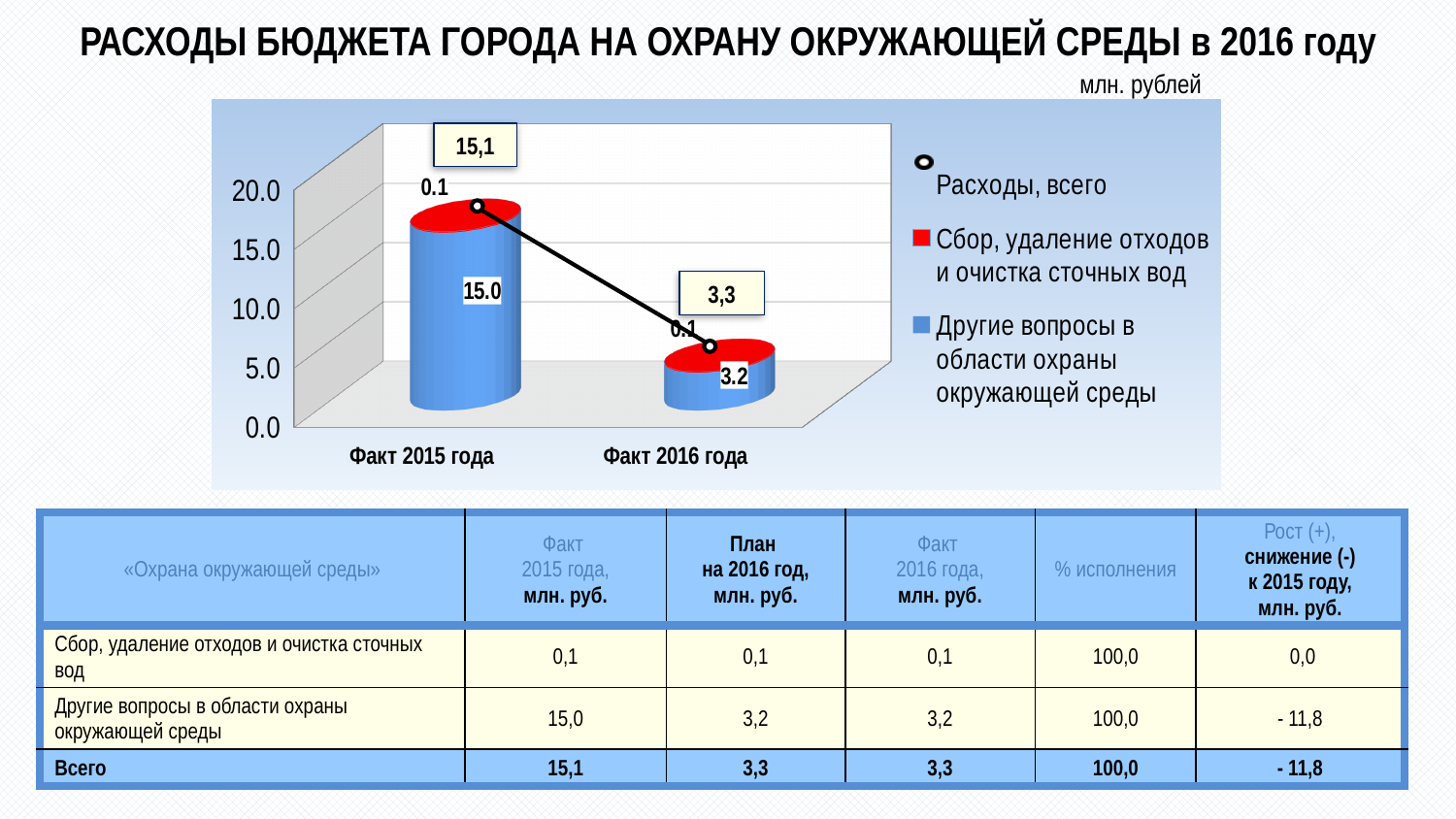
What is the value of the 'Сбор, удаление отходов и очистка сточных вод' series for 'Факт 2015 года'? 0.1 What is the difference between the 'Другие вопросы в области охраны окружающей среды' values for 'Факт 2015 года' and 'Факт 2016 года'? 11.8 Does the total expenditure rise or fall from 'Факт 2015 года' to 'Факт 2016 года'? fall Is the total for 'Факт 2016 года' greater or less than 5.0? less How many categories are shown on the x axis of the chart? 2 How many series does the chart legend list? 3 Which category has the higher total expenditure, 'Факт 2015 года' or 'Факт 2016 года'? Факт 2015 года What total is labelled for 'Факт 2016 года' on the chart? 3,3 What is the value of the 'Другие вопросы в области охраны окружающей среды' series for 'Факт 2016 года'? 3.2 What total is labelled for 'Факт 2015 года' on the chart? 15,1 What is the value of the 'Другие вопросы в области охраны окружающей среды' series for 'Факт 2015 года'? 15.0 What unit is stated for the values on the chart? млн. рублей